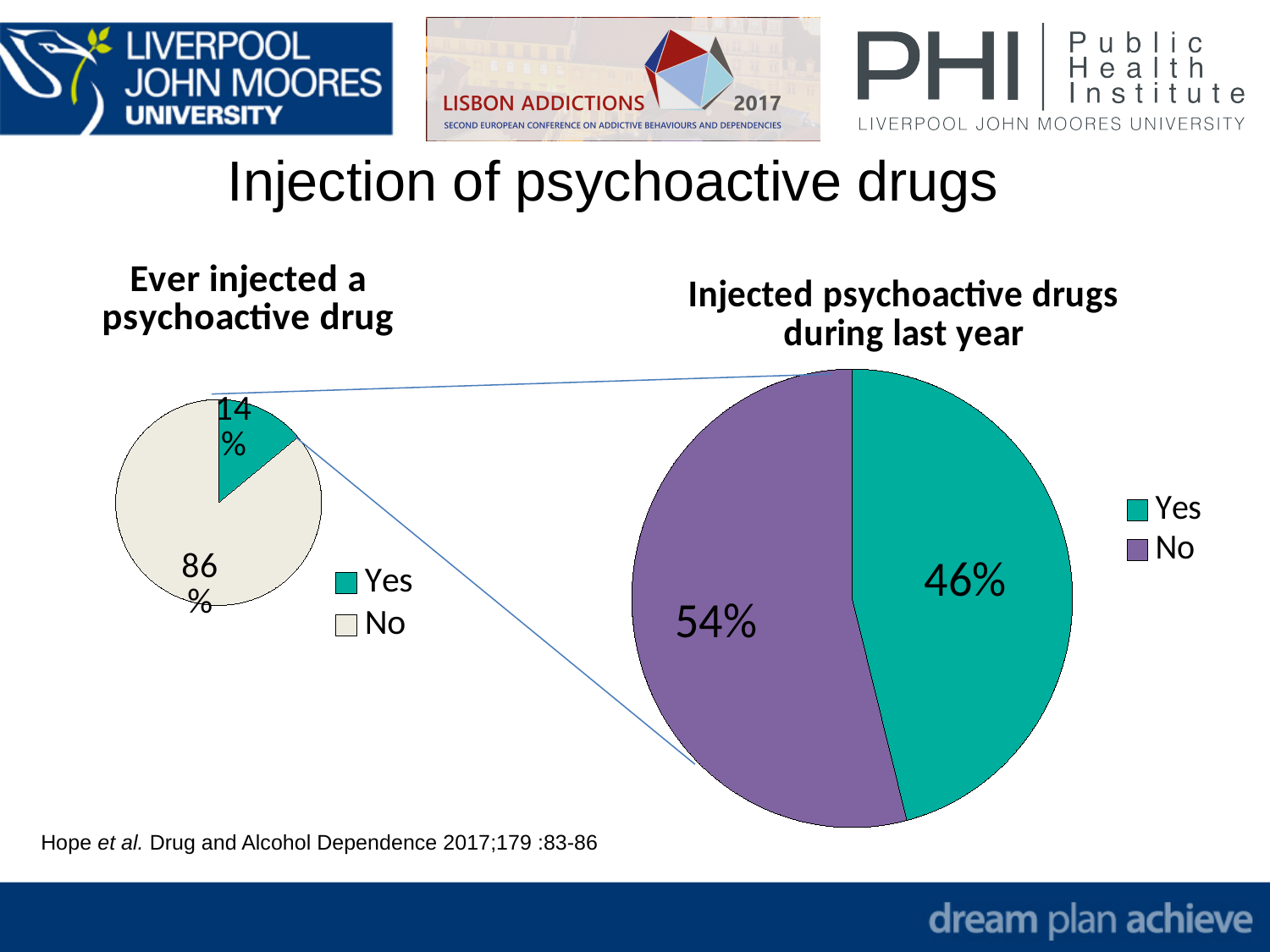
How many categories does the legend of the 'Ever injected a psychoactive drug' chart list? 2 In the 'Injected psychoactive drugs during last year' chart, which category has the smallest slice? Yes In the 'Injected psychoactive drugs during last year' chart, what percentage is shown for No? 54% In the 'Ever injected a psychoactive drug' chart, what percentage is shown for Yes? 14% In the 'Injected psychoactive drugs during last year' chart, what colour is the No slice? purple In the 'Injected psychoactive drugs during last year' chart, what percentage is shown for Yes? 46% In the 'Ever injected a psychoactive drug' chart, what is the difference between the No and Yes percentages? 72% In the 'Ever injected a psychoactive drug' chart, what percentage is shown for No? 86% In the 'Ever injected a psychoactive drug' chart, which category has the largest slice? No What type of chart is the 'Injected psychoactive drugs during last year' chart? pie chart In the 'Injected psychoactive drugs during last year' chart, what is the difference between the No and Yes percentages? 8% In the 'Injected psychoactive drugs during last year' chart, is the Yes slice larger or smaller than the No slice? smaller